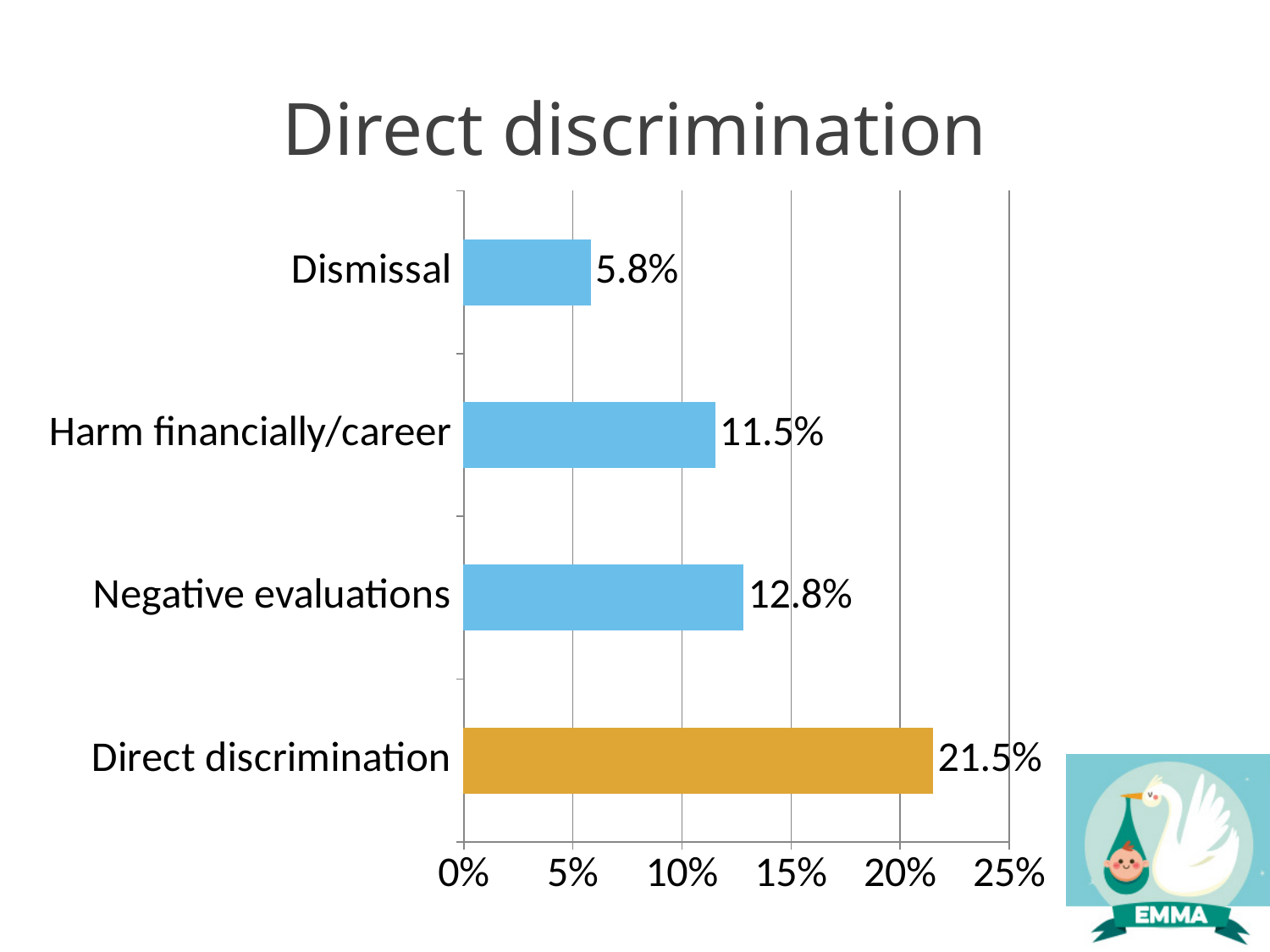
What is the value for Direct discrimination? 21.5% How many categories are shown in the chart? 4 What is the value for Negative evaluations? 12.8% Which category has the highest value? Direct discrimination Is the value for Direct discrimination greater or less than 20%? greater What kind of chart is shown on the slide? Bar chart What is the difference between the values for Negative evaluations and Harm financially/career? 1.3% Which is larger, the value for Harm financially/career or the value for Dismissal? Harm financially/career What is the difference between the values for Direct discrimination and Dismissal? 15.7% Which category has the lowest value? Dismissal What is the value for Dismissal? 5.8% What is the value for Harm financially/career? 11.5%